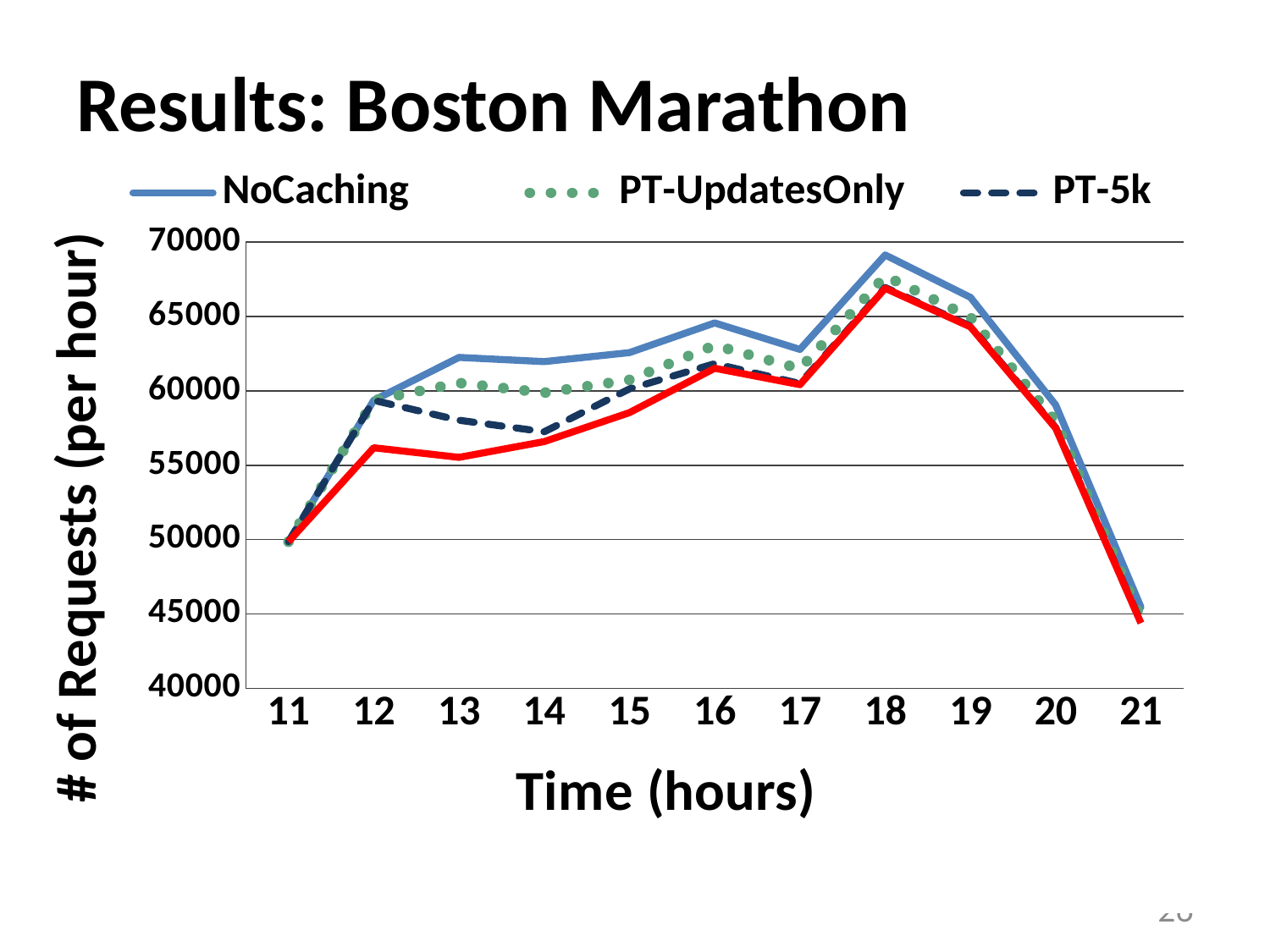
Is the value for PT-5k at hour 14 greater or less than 60000? less What kind of chart is shown on the slide? line chart At which hour does the NoCaching series reach its highest value? 18 Is the value for NoCaching at hour 18 greater or less than 65000? greater How many time points are plotted along the x axis? 11 Do the NoCaching values rise or fall from hour 18 to hour 21? fall Is the value for NoCaching at hour 21 greater or less than 50000? less How many series does the legend list? 3 At which hour does the NoCaching series reach its lowest value? 21 What is the title of the y axis? # of Requests (per hour) What is the title of the x axis? Time (hours) At hour 14, which is larger: NoCaching or PT-5k? NoCaching